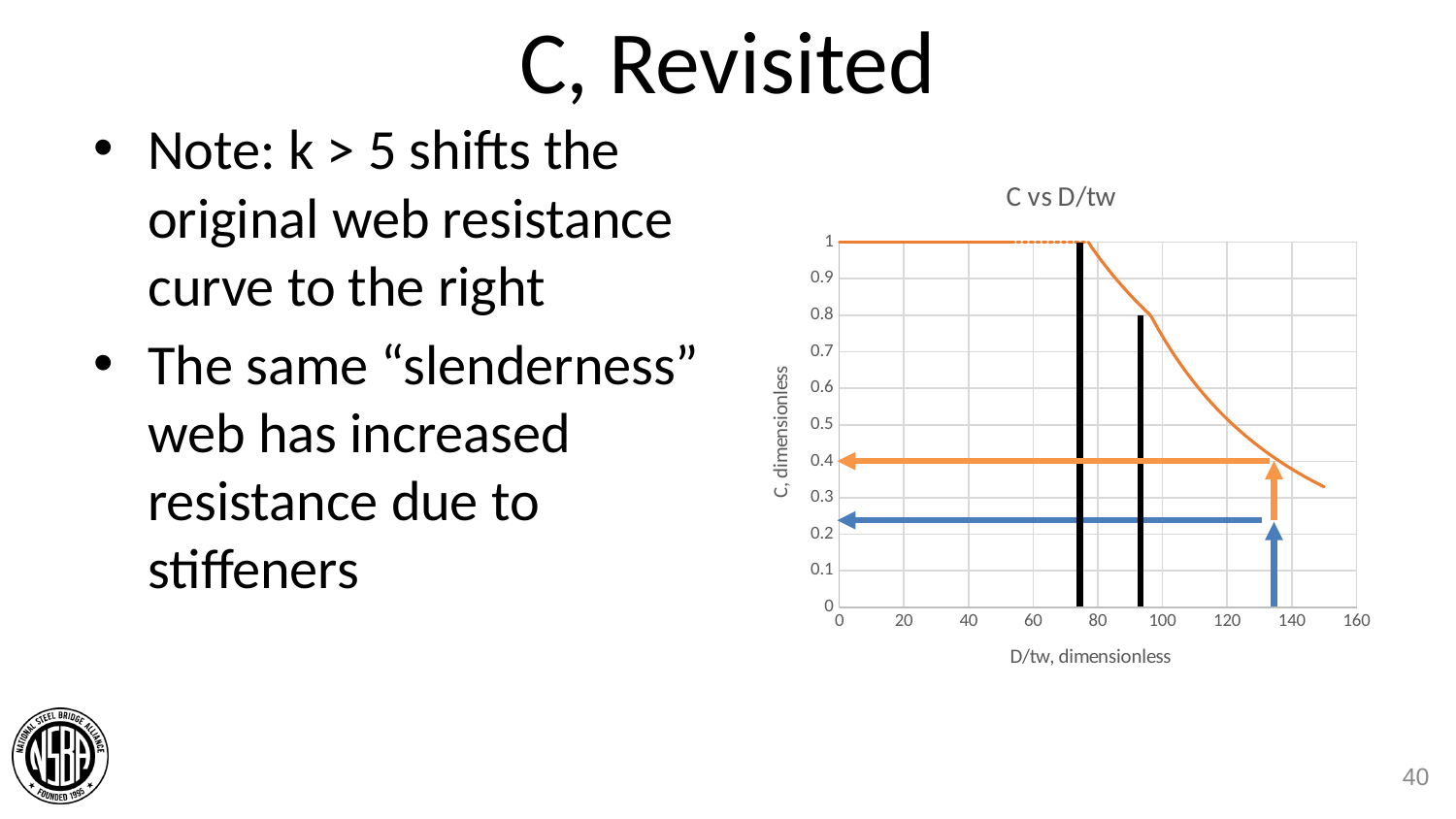
Which has the larger value of C: D/tw = 60 or D/tw = 120? D/tw = 60 Is the value of C at D/tw = 150 greater or less than 0.4? less Is the value of C at D/tw = 120 greater or less than 0.4? greater What is the highest value shown on the x axis? 160 What kind of chart is shown on the slide? line chart What is the title of the chart? C vs D/tw Is the value of C at D/tw = 100 greater or less than 0.5? greater What is the label of the x axis of the chart? D/tw, dimensionless What is the value of C at D/tw = 20? 1 Does the value of C rise or fall as D/tw increases beyond 80? fall